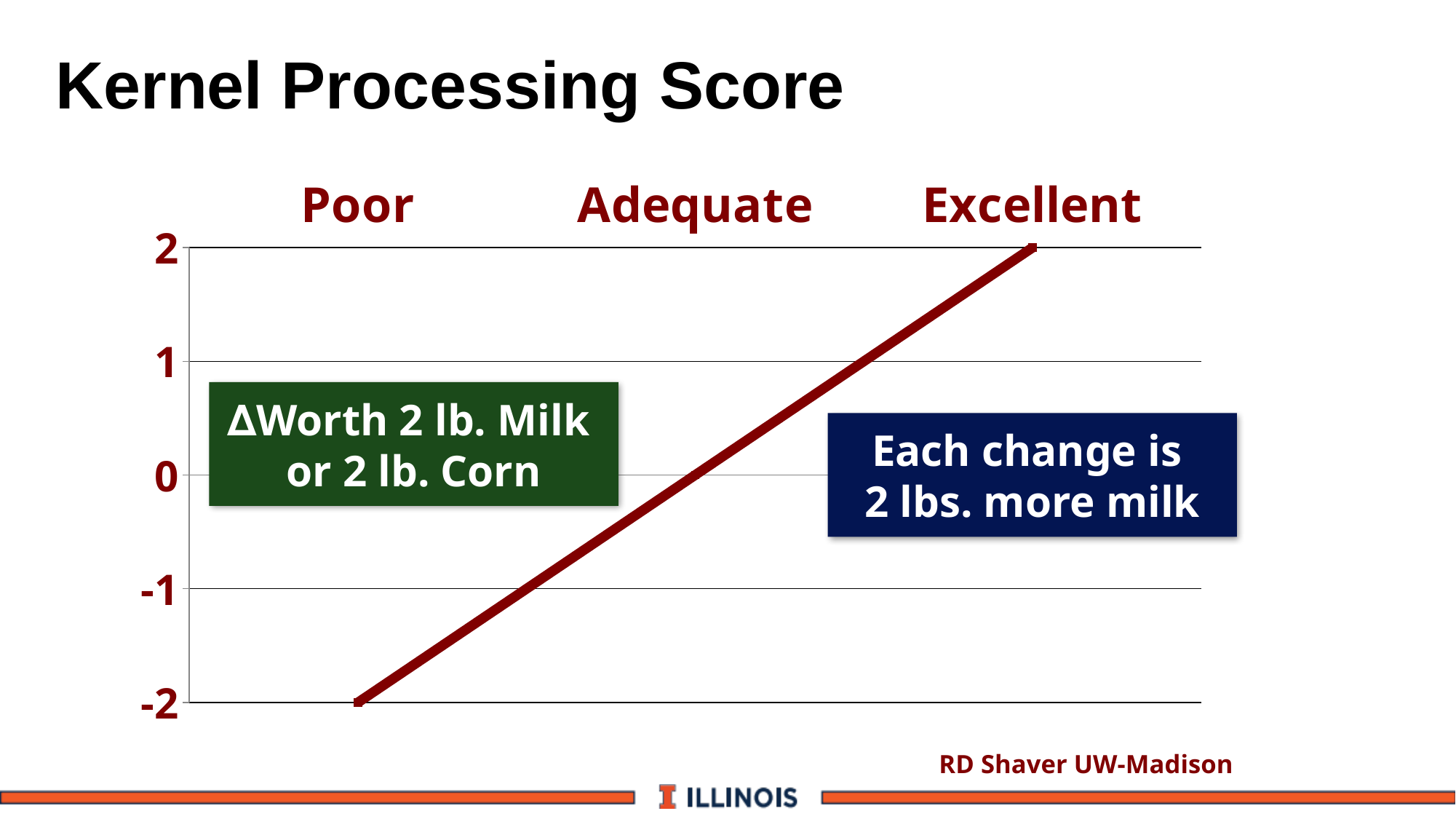
Which is larger, the value for Adequate or the value for Poor? Adequate Which category has the highest value? Excellent Which category has the lowest value? Poor What is the difference between the values for Excellent and Poor? 4 What is the title of the chart? Kernel Processing Score What kind of chart is shown on the slide? line chart What is the value for Poor? -2 What is the value for Adequate? 0 What is the value for Excellent? 2 Do the values rise or fall from Poor to Excellent? rise Is the value for Excellent greater or less than 1? greater How many categories are shown along the x axis? 3